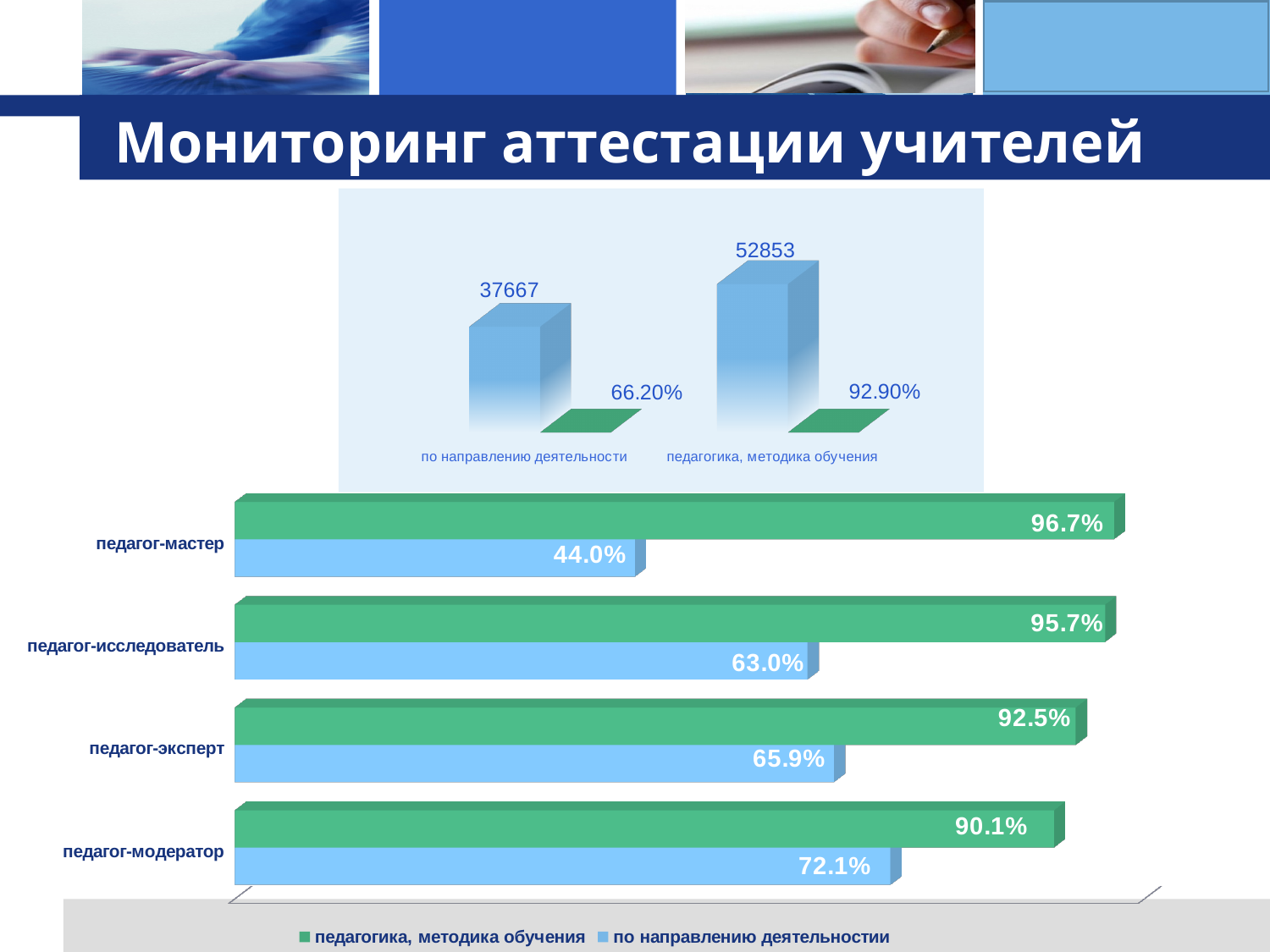
In the bottom horizontal bar chart, what is the value for педагог-модератор in the по направлению деятельностии series? 72.1% In the top chart, what value is labelled on the tall blue bar for педагогика, методика обучения? 52853 How many categories are shown in the bottom horizontal bar chart? 4 In the top chart, what percentage is shown for по направлению деятельности? 66.20% In the top chart, what is the difference between the two blue bar values, 52853 and 37667? 15186 How many series does the legend of the bottom horizontal bar chart list? 2 In the bottom horizontal bar chart, which category has the highest value in the по направлению деятельностии series? педагог-модератор In the bottom horizontal bar chart, what is the difference between the two series values for педагог-мастер? 52.7% In the bottom horizontal bar chart, what is the value for педагог-мастер in the педагогика, методика обучения series? 96.7% In the bottom horizontal bar chart, which is larger for педагог-эксперт: педагогика, методика обучения or по направлению деятельностии? педагогика, методика обучения What kind of chart is the bottom chart on the slide? bar chart In the bottom horizontal bar chart, which category has the lowest value in the педагогика, методика обучения series? педагог-модератор